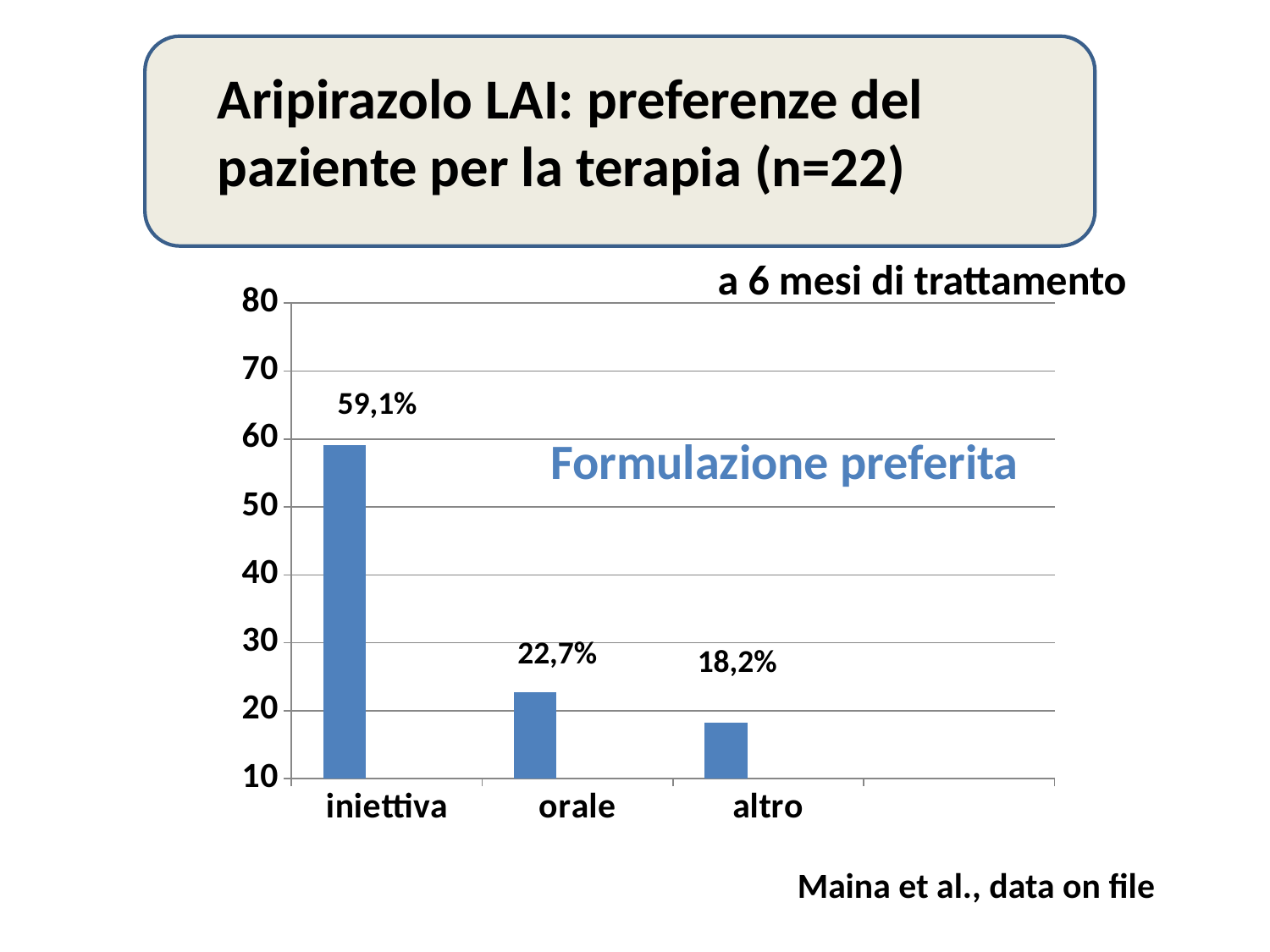
What is the value for orale? 22,7% What kind of chart is shown on the slide? bar chart Which is larger, the value for orale or the value for altro? orale What is the difference between the values for orale and altro? 4,5% Which category has the highest value? iniettiva What is the label shown in blue text inside the chart area? Formulazione preferita Which category has the lowest value? altro What is the value for iniettiva? 59,1% What is the difference between the values for iniettiva and orale? 36,4% Is the value for iniettiva greater or less than 50? greater How many categories are shown on the x axis? 3 What is the value for altro? 18,2%